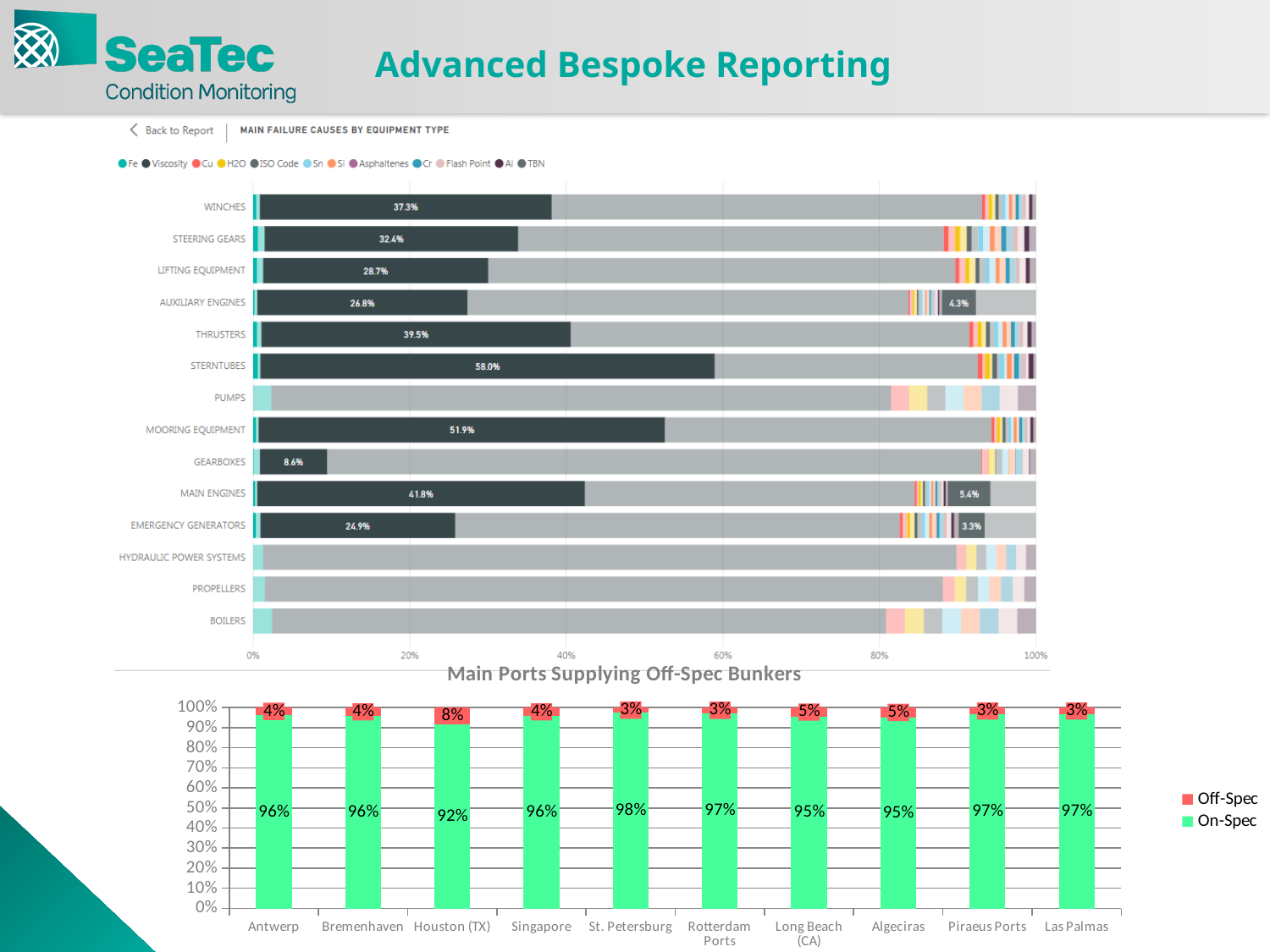
In the 'Main Ports Supplying Off-Spec Bunkers' chart, which is larger: the Off-Spec value for Long Beach (CA) or for Rotterdam Ports? Long Beach (CA) In the 'Main Ports Supplying Off-Spec Bunkers' chart, how many series does the legend list? 2 In the 'Main Ports Supplying Off-Spec Bunkers' chart, what is the Off-Spec value for Houston (TX)? 8% In the 'MAIN FAILURE CAUSES BY EQUIPMENT TYPE' chart, what is the labelled value of the dark segment for GEARBOXES? 8.6% In the 'Main Ports Supplying Off-Spec Bunkers' chart, what is the difference between the Off-Spec values for Houston (TX) and Antwerp? 4% In the 'MAIN FAILURE CAUSES BY EQUIPMENT TYPE' chart, what is the labelled value of the dark segment for STERNTUBES? 58.0% What kind of chart is 'Main Ports Supplying Off-Spec Bunkers'? Stacked bar chart In the 'Main Ports Supplying Off-Spec Bunkers' chart, what is the On-Spec value for St. Petersburg? 98% In the 'MAIN FAILURE CAUSES BY EQUIPMENT TYPE' chart, how many equipment types are listed on the y axis? 14 In the 'MAIN FAILURE CAUSES BY EQUIPMENT TYPE' chart, how many series does the legend list? 12 In the 'Main Ports Supplying Off-Spec Bunkers' chart, how many ports are shown on the x axis? 10 In the 'Main Ports Supplying Off-Spec Bunkers' chart, which port has the highest Off-Spec share? Houston (TX)